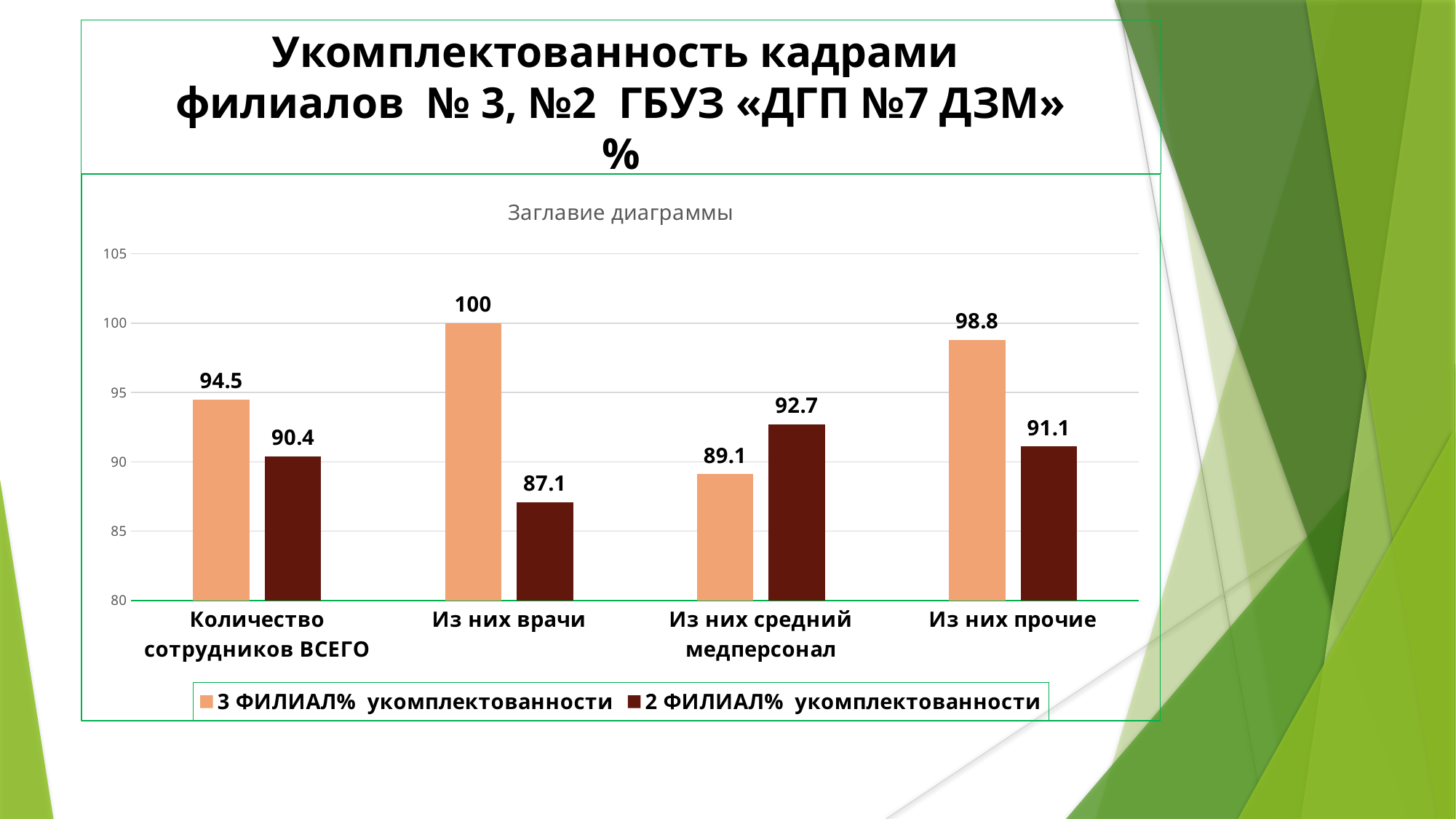
For "Из них средний медперсонал", which series has the larger value? 2 ФИЛИАЛ% укомплектованности Which category has the lowest value in the "2 ФИЛИАЛ% укомплектованности" series? Из них врачи What kind of chart is shown on the slide? bar chart What is the value for "Из них средний медперсонал" in the "2 ФИЛИАЛ% укомплектованности" series? 92.7 What is the placeholder title shown above the chart? Заглавие диаграммы How many series does the legend list? 2 Is the value for "Из них прочие" in the "3 ФИЛИАЛ% укомплектованности" series greater or less than 95? greater Which category has the highest value in the "3 ФИЛИАЛ% укомплектованности" series? Из них врачи What is the difference between the "3 ФИЛИАЛ% укомплектованности" and "2 ФИЛИАЛ% укомплектованности" values for "Из них врачи"? 12.9 What is the value for "Из них врачи" in the "3 ФИЛИАЛ% укомплектованности" series? 100 How many categories are shown on the x axis? 4 What is the value for "Количество сотрудников ВСЕГО" in the "2 ФИЛИАЛ% укомплектованности" series? 90.4